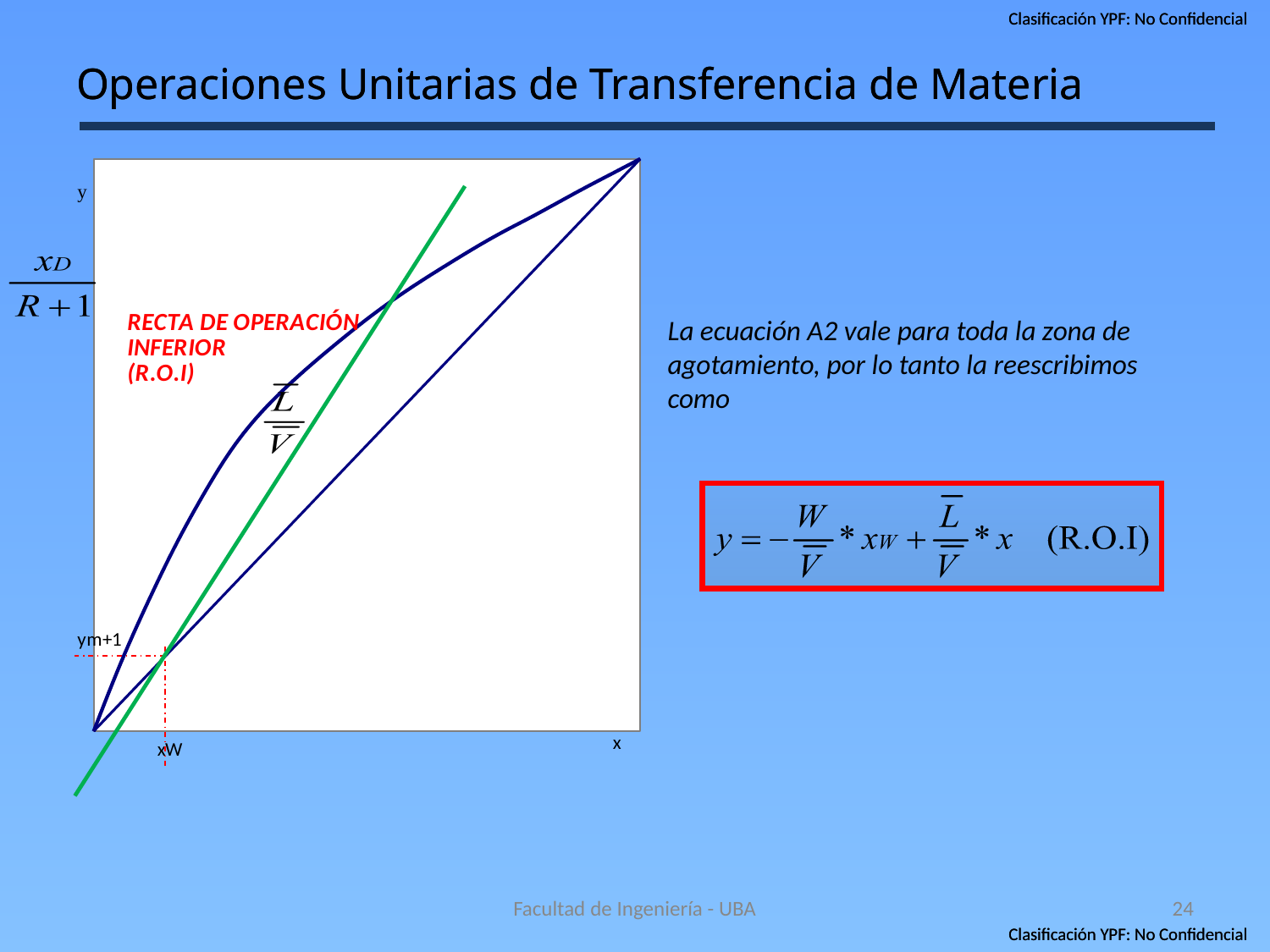
What kind of chart is shown on the slide? line chart Does the curved dark blue line rise or fall as x increases? rise How many lines are plotted in the chart? 2 What label is written on the x axis of the chart? x What is the green line in the chart labelled as? RECTA DE OPERACIÓN INFERIOR (R.O.I)